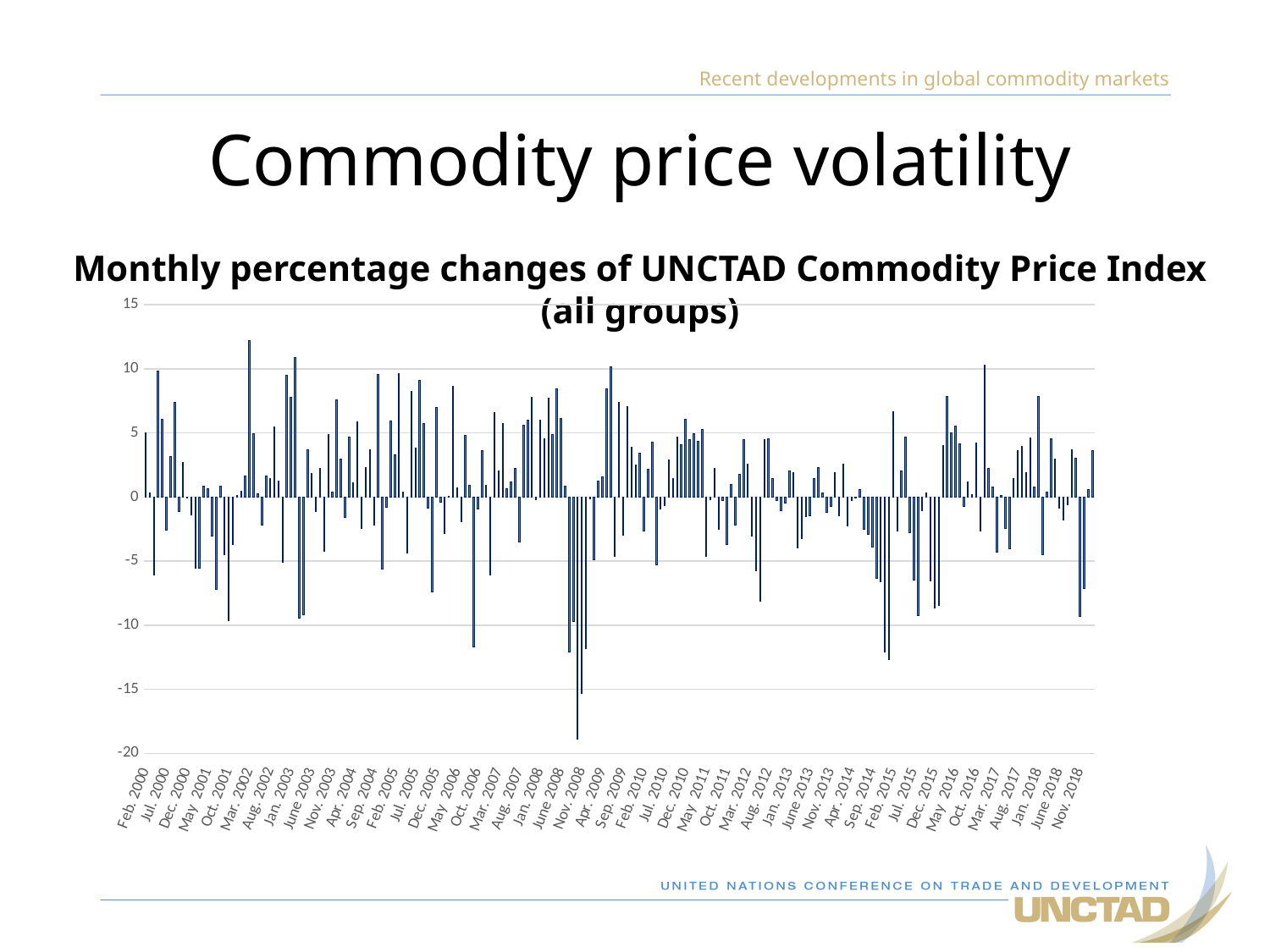
What is the highest value shown on the vertical axis of the chart? 15 What is the title of the chart? Monthly percentage changes of UNCTAD Commodity Price Index (all groups) Is the lowest bar on the chart greater or less than -15? less How many data series are plotted on the chart? 1 Is the highest bar on the chart greater or less than 10? greater What is the lowest value shown on the vertical axis of the chart? -20 In which year does the lowest value on the chart occur? 2008 What kind of chart is shown on the slide? bar chart What is the first month label on the horizontal axis? Feb. 2000